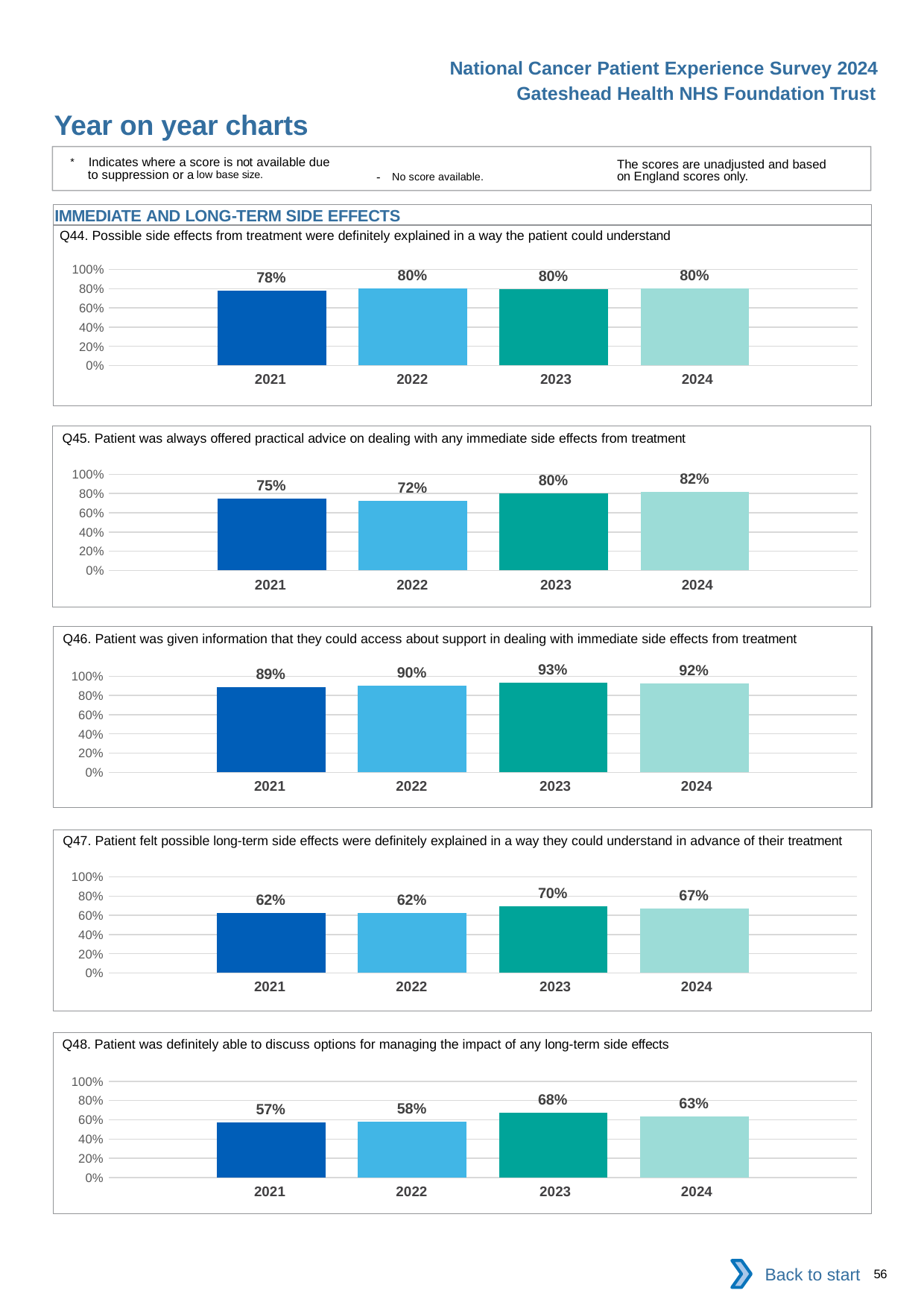
What kind of chart is the Q46 chart? bar chart In the Q44 chart, what is the value for 2021? 78% In the Q45 chart, do the values rise or fall from 2022 to 2024? rise In the Q45 chart, which year has the lowest value? 2022 In the Q48 chart, is the value for 2021 greater or less than 60%? less In the Q45 chart, which year has the highest value? 2024 How many charts are shown on the slide? 5 In the Q47 chart, what is the difference between the 2023 value and the 2021 value? 8% In the Q46 chart, what is the difference between the 2023 value and the 2021 value? 4% In the Q47 chart, which is larger, the value for 2023 or the value for 2024? 2023 How many years are shown on the x axis of the Q44 chart? 4 In the Q48 chart, what is the value for 2023? 68%